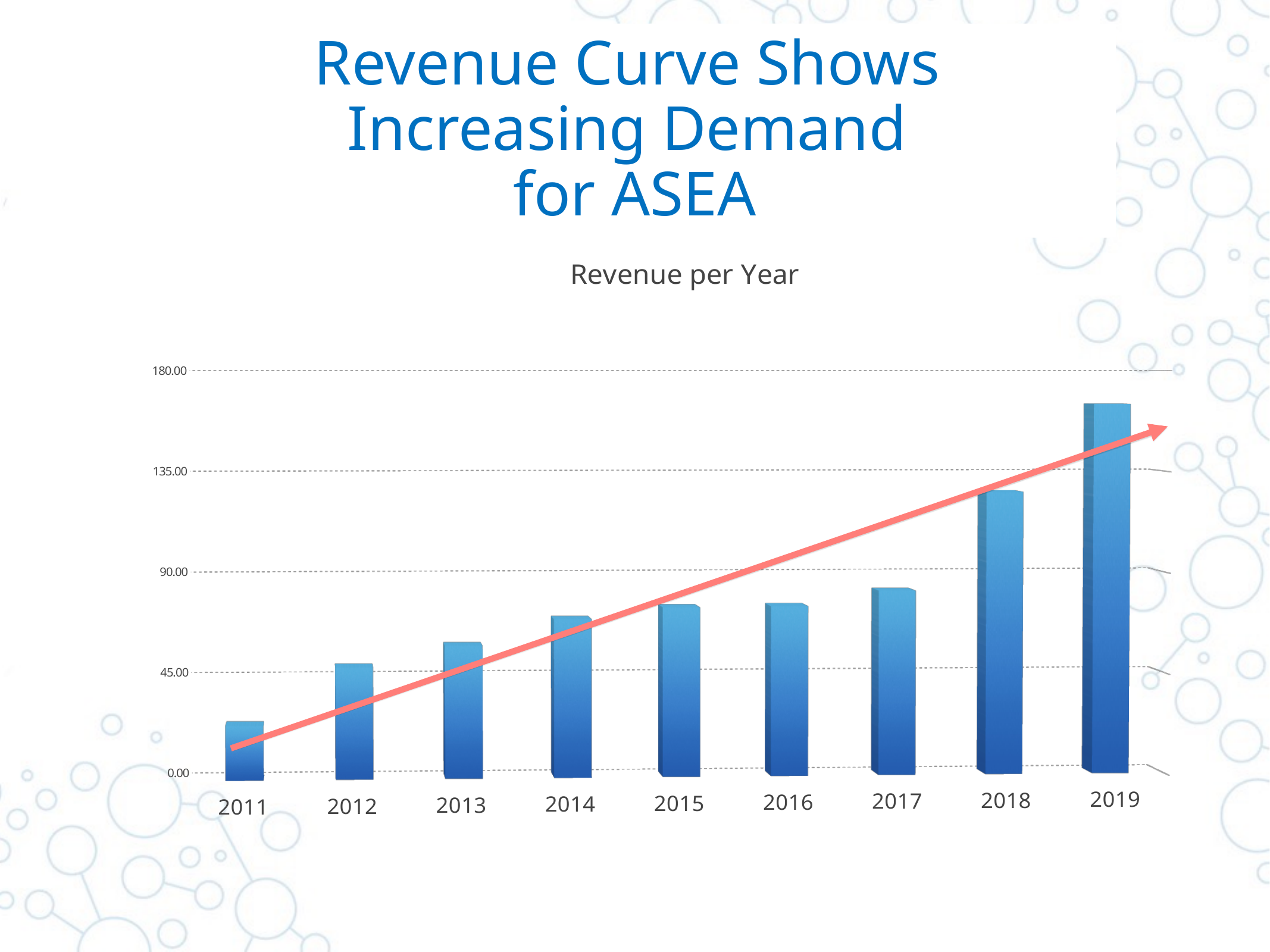
Which year has the lowest revenue in the chart? 2011 What kind of chart is shown on the slide? bar chart Is the revenue for 2012 greater or less than 45.00? greater Is the revenue for 2011 greater or less than 45.00? less Which year has the larger revenue, 2013 or 2018? 2018 How many years are shown on the x axis of the chart? 9 Is the revenue for 2018 greater or less than 135.00? less What is the title of the chart? Revenue per Year Which year has the highest revenue in the chart? 2019 Do the revenue values generally rise or fall from 2011 to 2019? rise